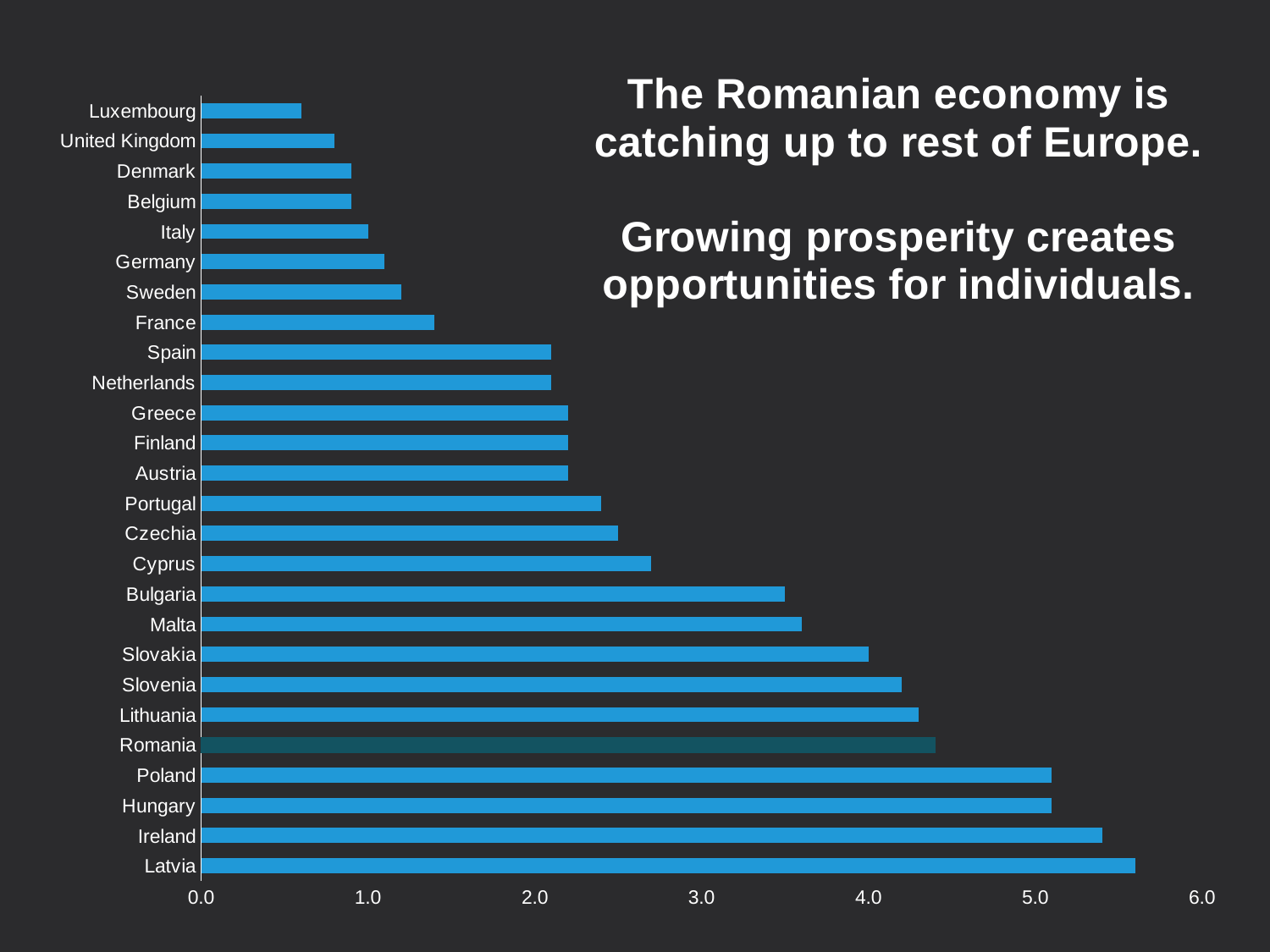
Which has the larger value, Ireland or Hungary? Ireland Which country has the lowest value in the chart? Luxembourg Is the value for France greater or less than 2.0? less How many countries are shown in the chart? 26 Is the value for Bulgaria greater or less than 3.0? greater Which has the larger value, Romania or Slovakia? Romania Which country has the highest value in the chart? Latvia Is the value for Luxembourg greater or less than 1.0? less What kind of chart is shown on the slide? bar chart Which country's bar is shown in a different, darker colour from the others? Romania